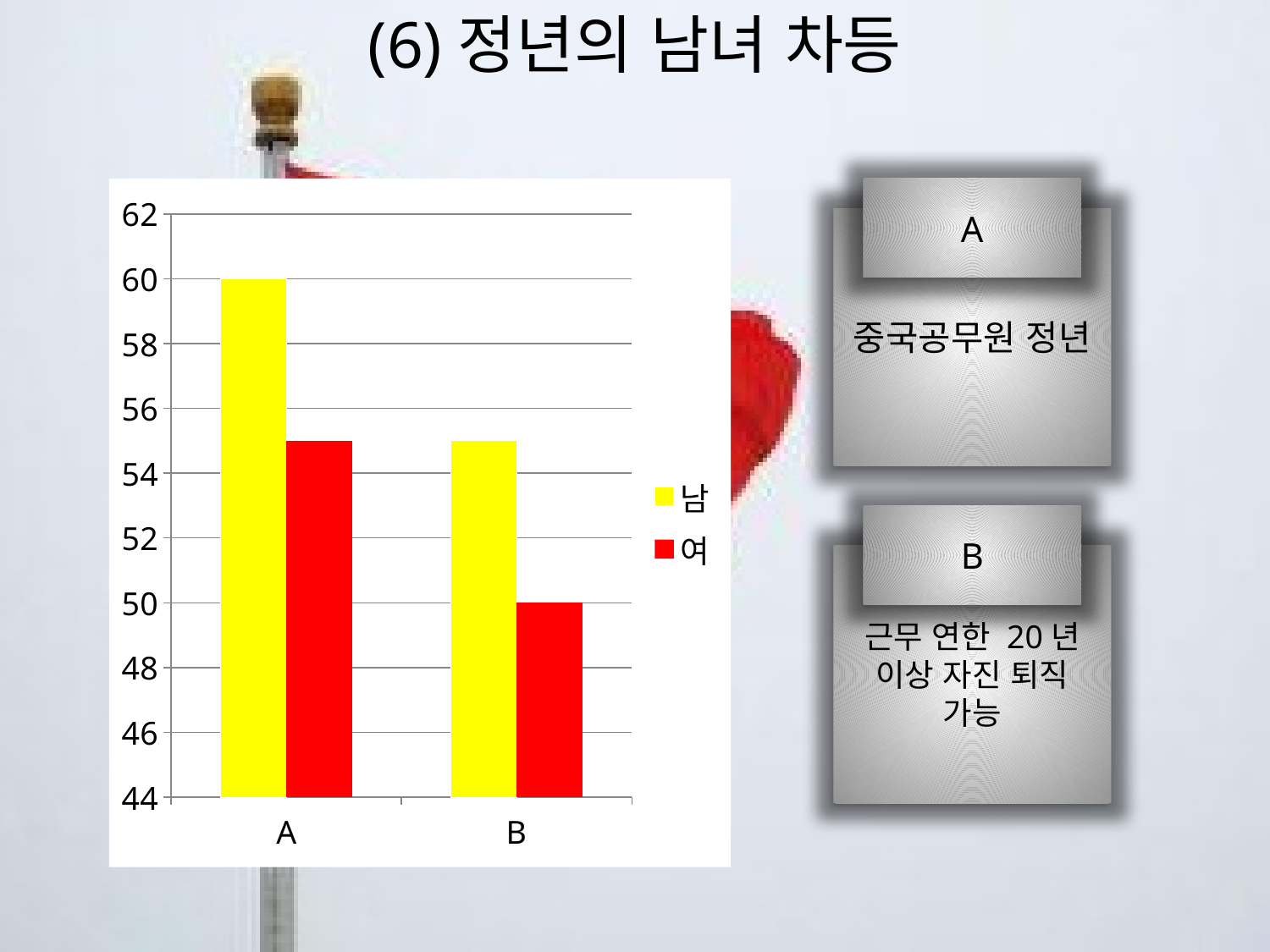
How many categories are shown on the x axis of the chart? 2 Which colour represents the 여 series in the chart? red How many series does the chart legend list? 2 Which category has the lowest 여 value? B What is the difference between the 남 value in category A and the 여 value in category B? 10 Which is larger: 남 in category A or 여 in category A? 남 in category A What type of chart is shown on the slide? bar chart What is the value for 남 in category A? 60 Is the value for 여 in category A greater or less than 54? greater Is the value for 남 in category B greater or less than 56? less What is the value for 여 in category B? 50 Which category has the highest 남 value? A